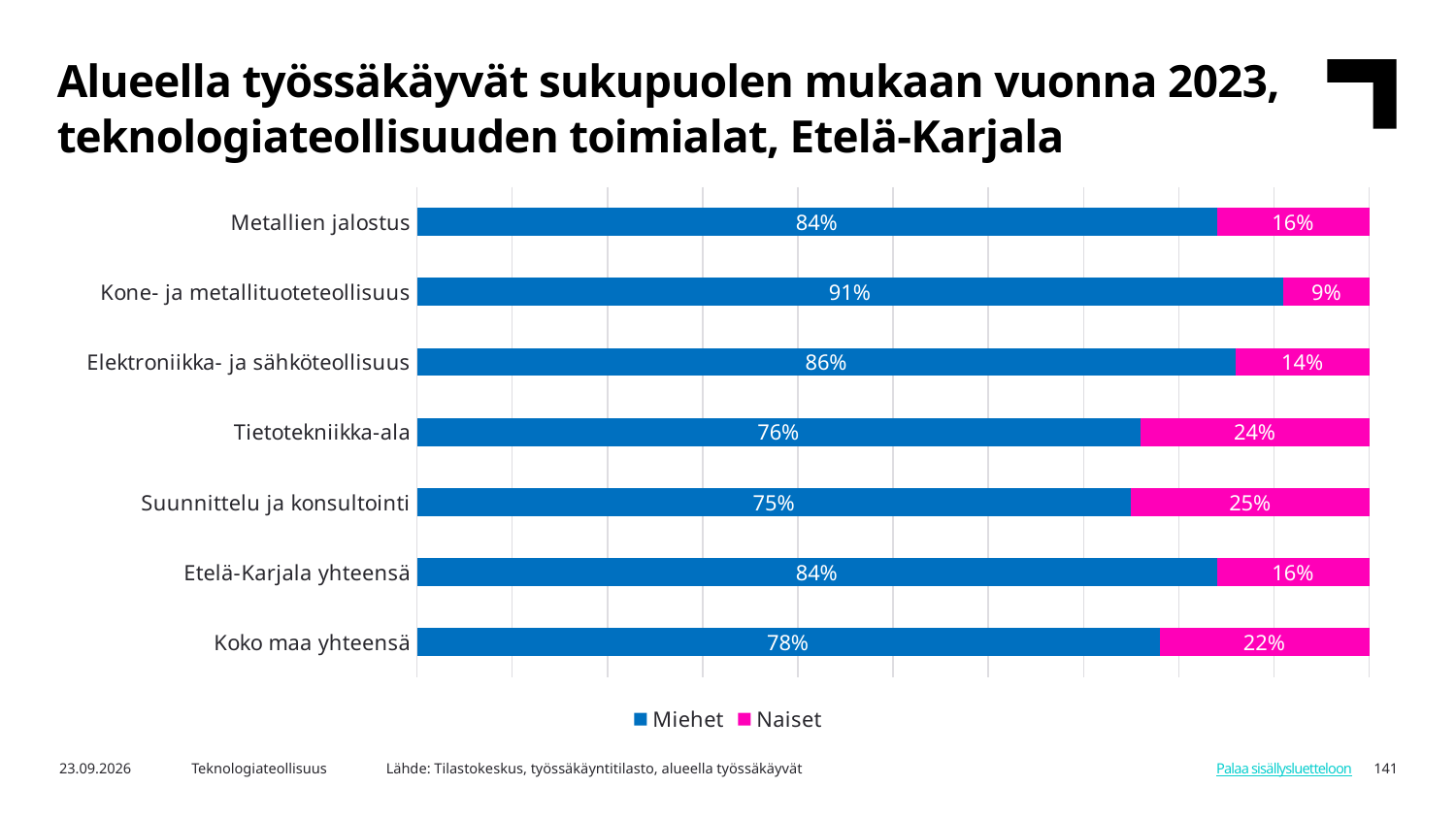
Which is larger: the Naiset share for Tietotekniikka-ala or for Metallien jalostus? Tietotekniikka-ala Which category has the highest Naiset share? Suunnittelu ja konsultointi What is the Naiset share for Suunnittelu ja konsultointi? 25% How many series does the legend list? 2 What is the Miehet share for Kone- ja metallituoteteollisuus? 91% How many categories are shown on the chart? 7 Which category has the lowest Naiset share? Kone- ja metallituoteteollisuus What is the difference between the Miehet share for Kone- ja metallituoteteollisuus and for Tietotekniikka-ala? 15 percentage points What is the Naiset share for Koko maa yhteensä? 22% What is the total of the stacked bar for Etelä-Karjala yhteensä? 100% What is the Miehet share for Elektroniikka- ja sähköteollisuus? 86% What kind of chart is shown on the slide? Stacked bar chart